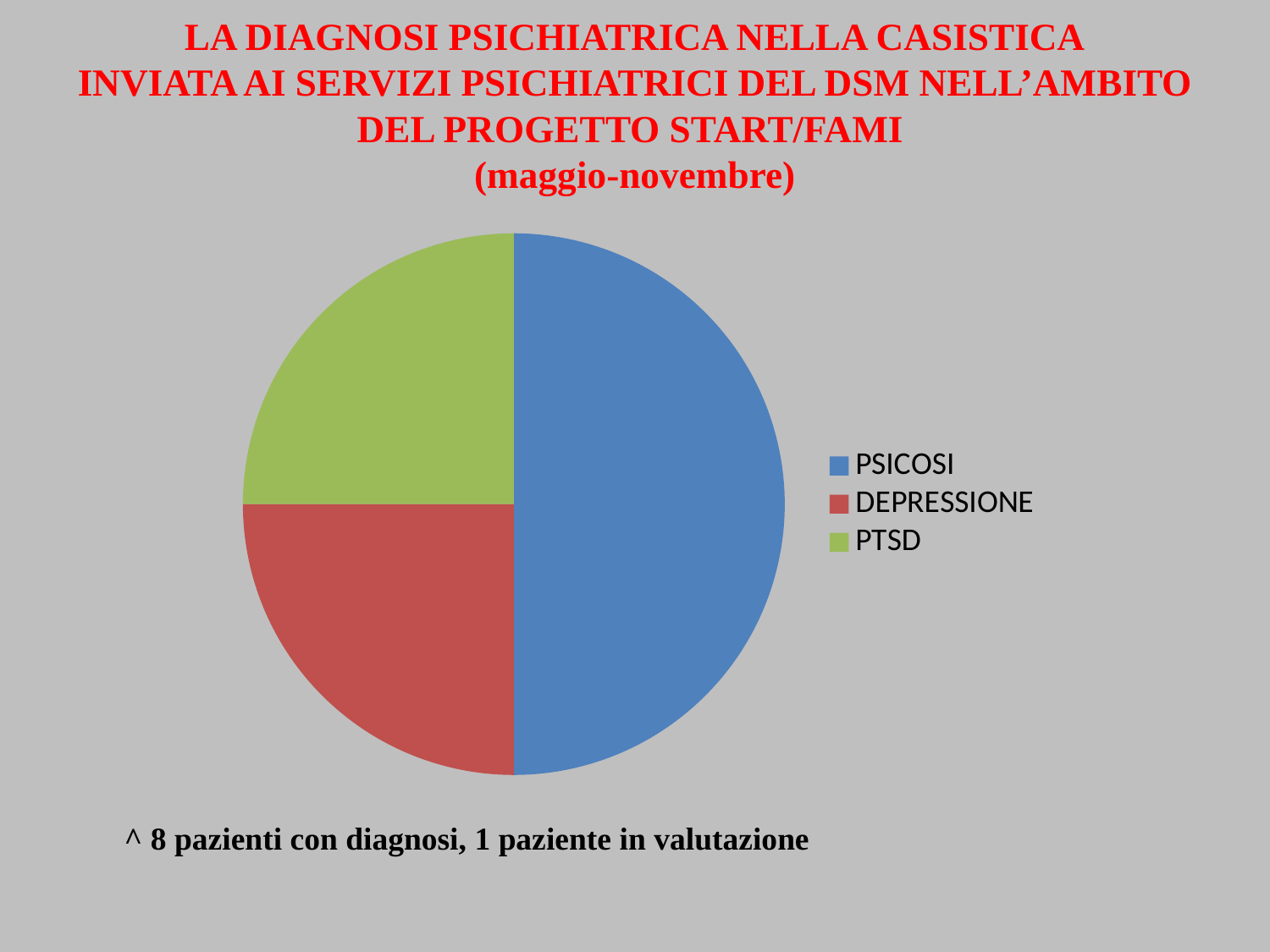
Which diagnosis has the largest slice in the pie chart? PSICOSI Which slice is larger, PSICOSI or DEPRESSIONE? PSICOSI Which diagnosis is shown in blue in the pie chart? PSICOSI How many entries does the legend of the pie chart list? 3 What kind of chart is shown on the slide? pie chart Which colour represents PTSD in the pie chart? green How many slices does the pie chart have? 3 Which slice is larger, PSICOSI or PTSD? PSICOSI